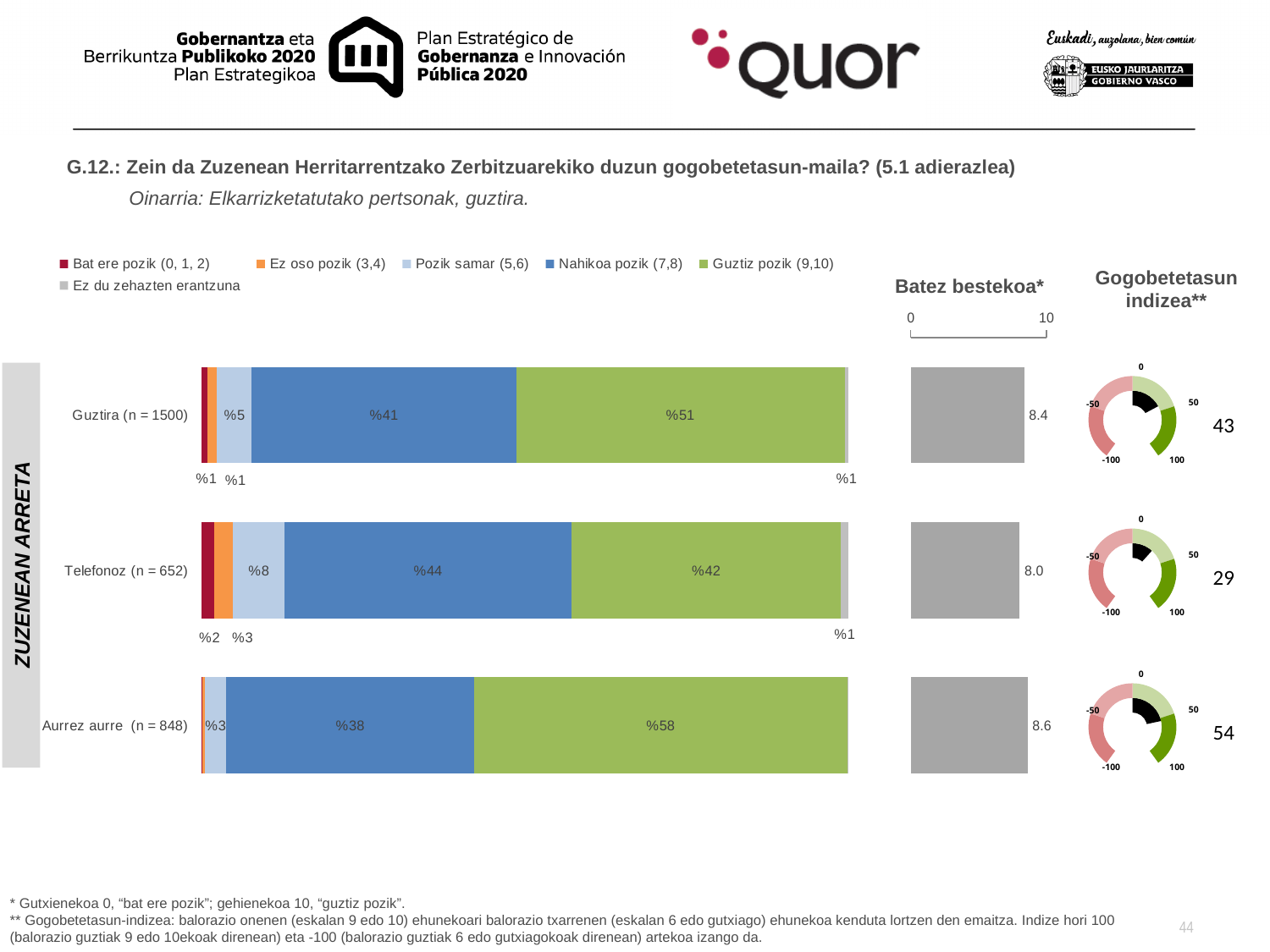
In the 'Batez bestekoa*' chart, what is the value for Telefonoz (n = 652)? 8.0 In the stacked bar chart, which category has the highest 'Guztiz pozik (9,10)' value? Aurrez aurre (n = 848) In the stacked bar chart, what is the 'Ez oso pozik (3,4)' value for Telefonoz (n = 652)? %3 In the stacked bar chart, is the 'Nahikoa pozik (7,8)' value larger for Telefonoz (n = 652) or for Aurrez aurre (n = 848)? Telefonoz (n = 652) How many series does the legend of the stacked bar chart list? 6 In the stacked bar chart, what is the 'Nahikoa pozik (7,8)' value for Telefonoz (n = 652)? %44 In the stacked bar chart, what is the 'Guztiz pozik (9,10)' value for Guztira (n = 1500)? %51 In the stacked bar chart, what is the difference between the 'Guztiz pozik (9,10)' values for Aurrez aurre (n = 848) and Telefonoz (n = 652)? 16 percentage points In the 'Gogobetetasun indizea**' gauges, which category has the highest index value? Aurrez aurre (n = 848) How many categories are shown in the stacked bar chart? 3 In the stacked bar chart, which category has the lowest 'Guztiz pozik (9,10)' value? Telefonoz (n = 652) In the stacked bar chart, what is the 'Pozik samar (5,6)' value for Aurrez aurre (n = 848)? %3